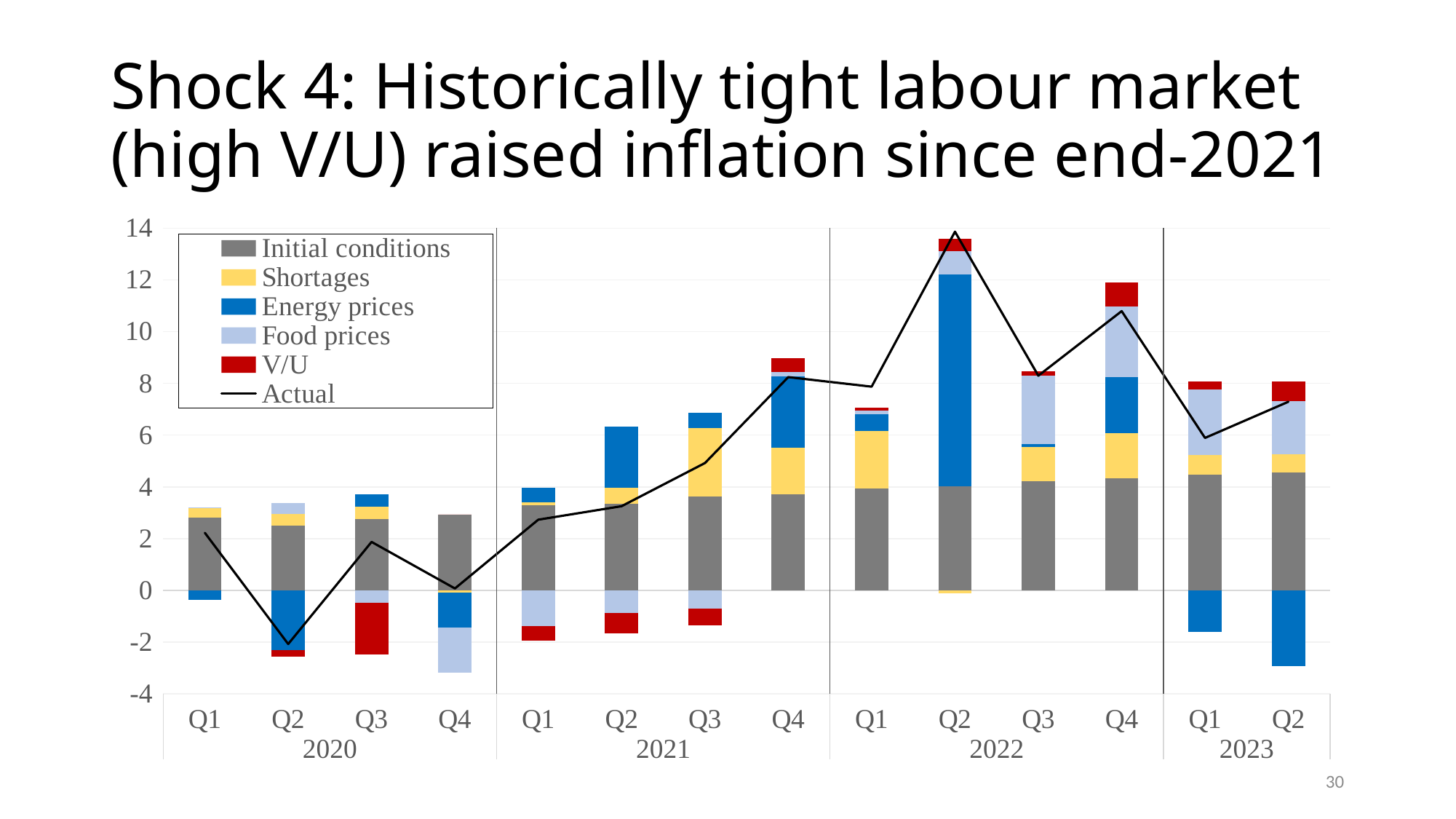
What kind of chart is shown on the slide? Stacked bar chart with a line Which legend entry is shown in red? V/U What is the title of the slide? Shock 4: Historically tight labour market (high V/U) raised inflation since end-2021 Which is larger, the Actual value for Q1 2021 or for Q1 2022? Q1 2022 In which quarter does the Actual line reach its lowest value? Q2 2020 Is the Actual value for Q1 2023 greater or less than 8? less Is the Actual value for Q2 2022 greater or less than 12? greater Does the Actual line rise or fall from Q4 2020 to Q4 2021? rise In which quarter does the Actual line reach its highest value? Q2 2022 How many quarters are plotted along the x axis? 14 How many series does the legend list? 6 Is the Actual value for Q4 2020 greater or less than 2? less